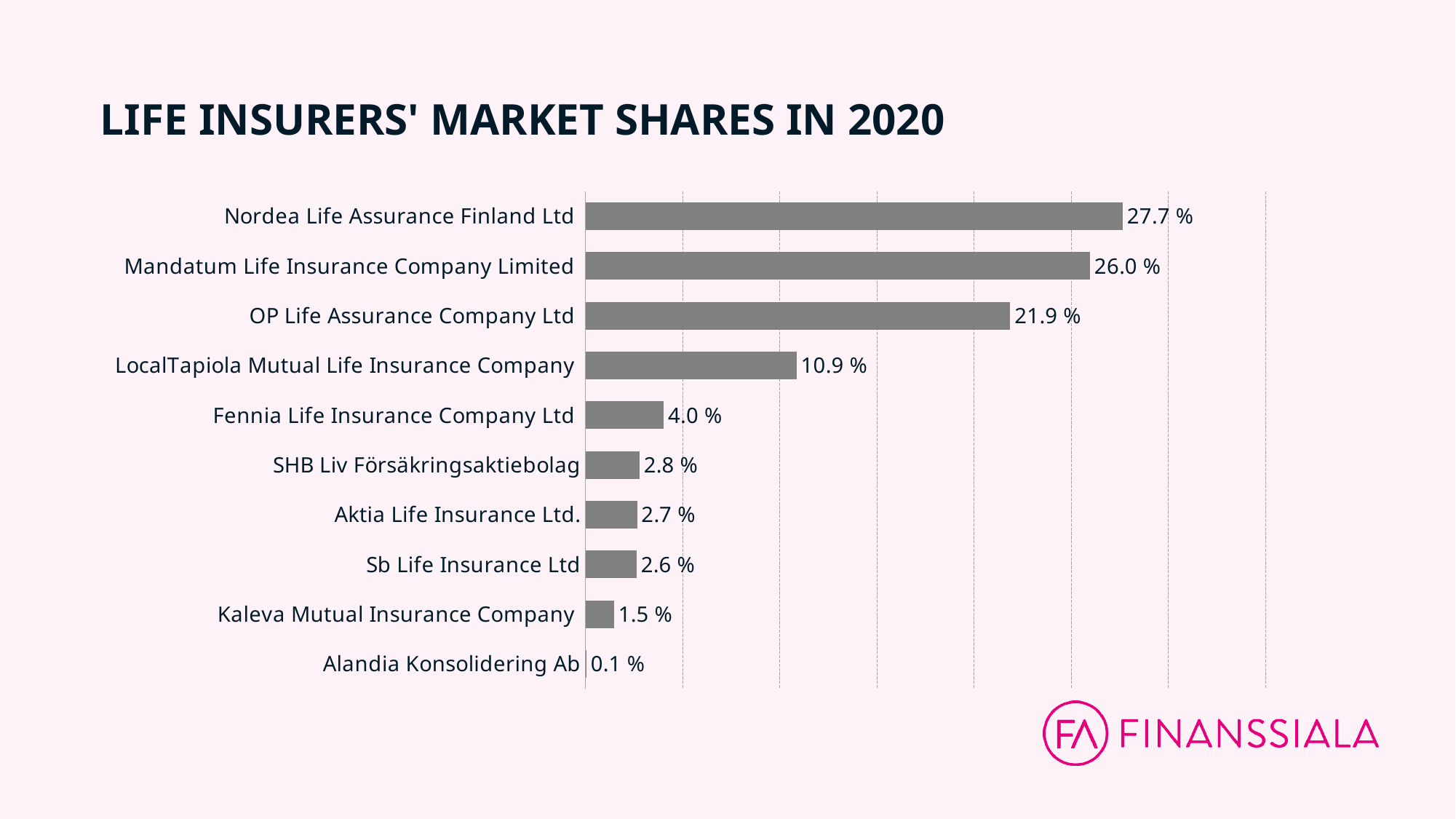
What is the title of the chart? LIFE INSURERS' MARKET SHARES IN 2020 What is the market share of LocalTapiola Mutual Life Insurance Company? 10.9 % Which life insurer has the largest market share? Nordea Life Assurance Finland Ltd Which life insurer has the smallest market share? Alandia Konsolidering Ab What is the market share of Kaleva Mutual Insurance Company? 1.5 % What is the market share of Nordea Life Assurance Finland Ltd? 27.7 % What is the difference in market share between Nordea Life Assurance Finland Ltd and Mandatum Life Insurance Company Limited? 1.7 % Which has a larger market share, Fennia Life Insurance Company Ltd or SHB Liv Försäkringsaktiebolag? Fennia Life Insurance Company Ltd What is the difference in market share between OP Life Assurance Company Ltd and LocalTapiola Mutual Life Insurance Company? 11.0 % How many life insurers are shown in the chart? 10 What kind of chart is shown on the slide? Bar chart Which has a larger market share, Mandatum Life Insurance Company Limited or OP Life Assurance Company Ltd? Mandatum Life Insurance Company Limited